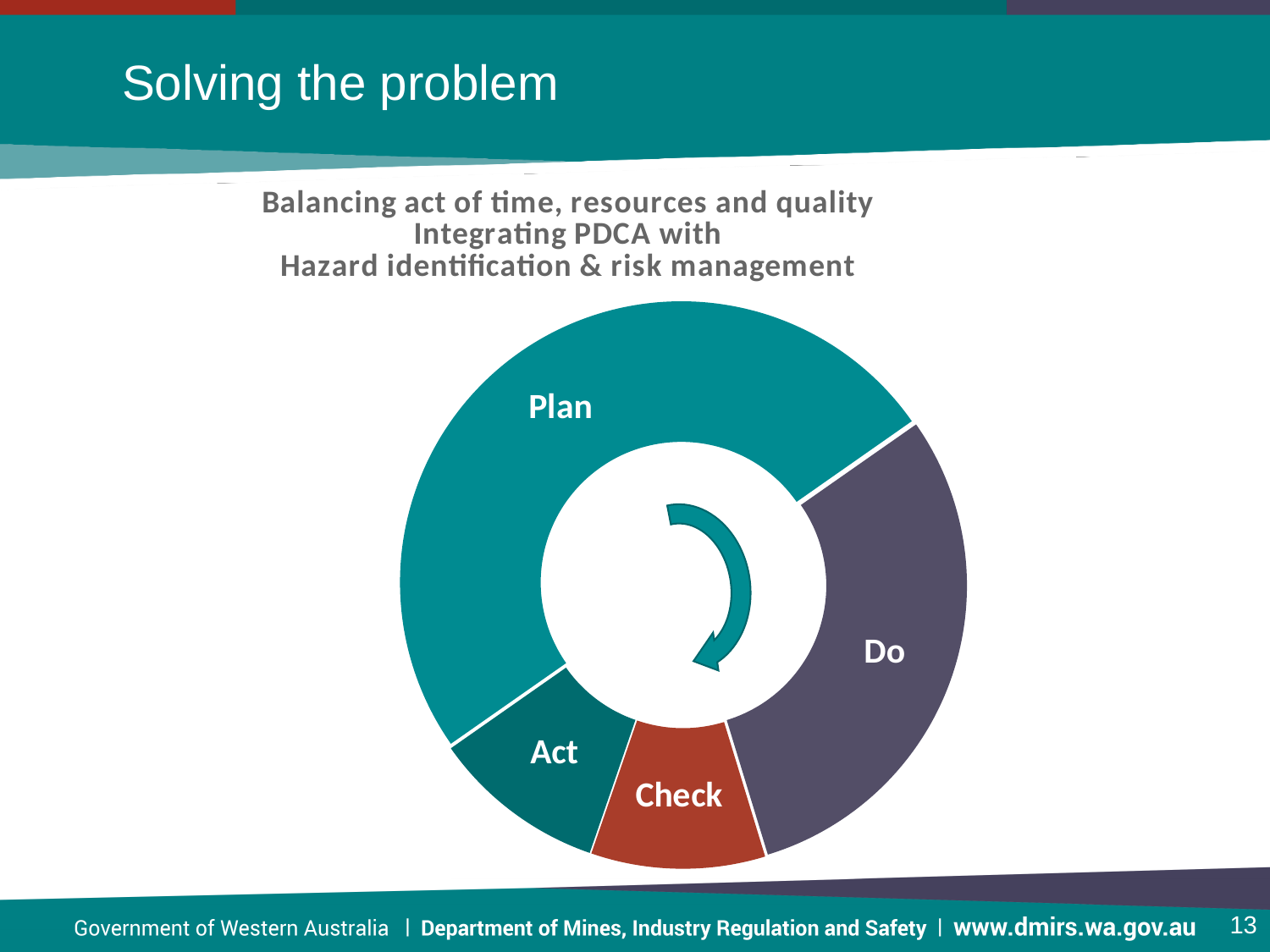
Which segment is larger, Plan or Check? Plan Which segment is larger, Do or Check? Do What kind of chart is shown on the slide? Donut chart How many segments does the donut chart have? 4 What are the labels of the four segments in the donut chart? Plan, Do, Check, Act Which segment is larger, Plan or Do? Plan Which segment of the donut chart is the largest? Plan What colour is the Check segment of the donut chart? Red